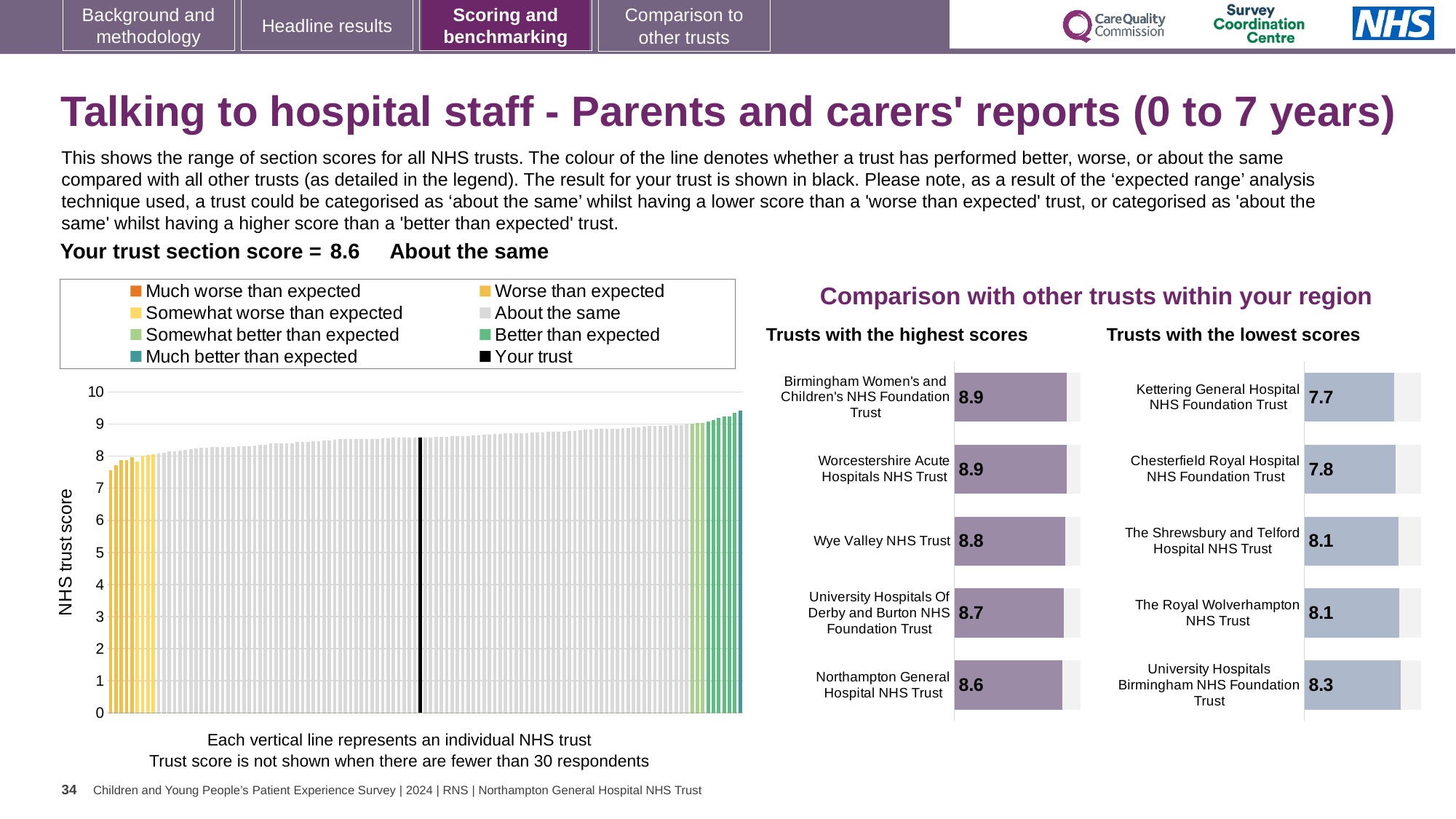
In the NHS trust score chart on the left, do the bar heights rise or fall from left to right? Rise How many entries does the legend of the NHS trust score chart list? 8 In the 'Trusts with the highest scores' chart, how many trusts are listed? 5 In the 'Trusts with the lowest scores' chart, which trust has the lowest score? Kettering General Hospital NHS Foundation Trust In the 'Trusts with the lowest scores' chart, what is the difference between the score for University Hospitals Birmingham NHS Foundation Trust and the score for Kettering General Hospital NHS Foundation Trust? 0.6 In the 'Trusts with the highest scores' chart, what is the difference between the score for Birmingham Women's and Children's NHS Foundation Trust and the score for Northampton General Hospital NHS Trust? 0.3 In the 'Trusts with the lowest scores' chart, which has the larger score: Chesterfield Royal Hospital NHS Foundation Trust or Kettering General Hospital NHS Foundation Trust? Chesterfield Royal Hospital NHS Foundation Trust In the 'Trusts with the lowest scores' chart, which trust has the highest score? University Hospitals Birmingham NHS Foundation Trust In the NHS trust score chart on the left, is the value for the black 'Your trust' bar greater or less than 8? greater In the 'Trusts with the highest scores' chart, what is the score for Wye Valley NHS Trust? 8.8 In the 'Trusts with the lowest scores' chart, what is the score for Kettering General Hospital NHS Foundation Trust? 7.7 What kind of chart is the NHS trust score chart on the left of the slide? Bar chart